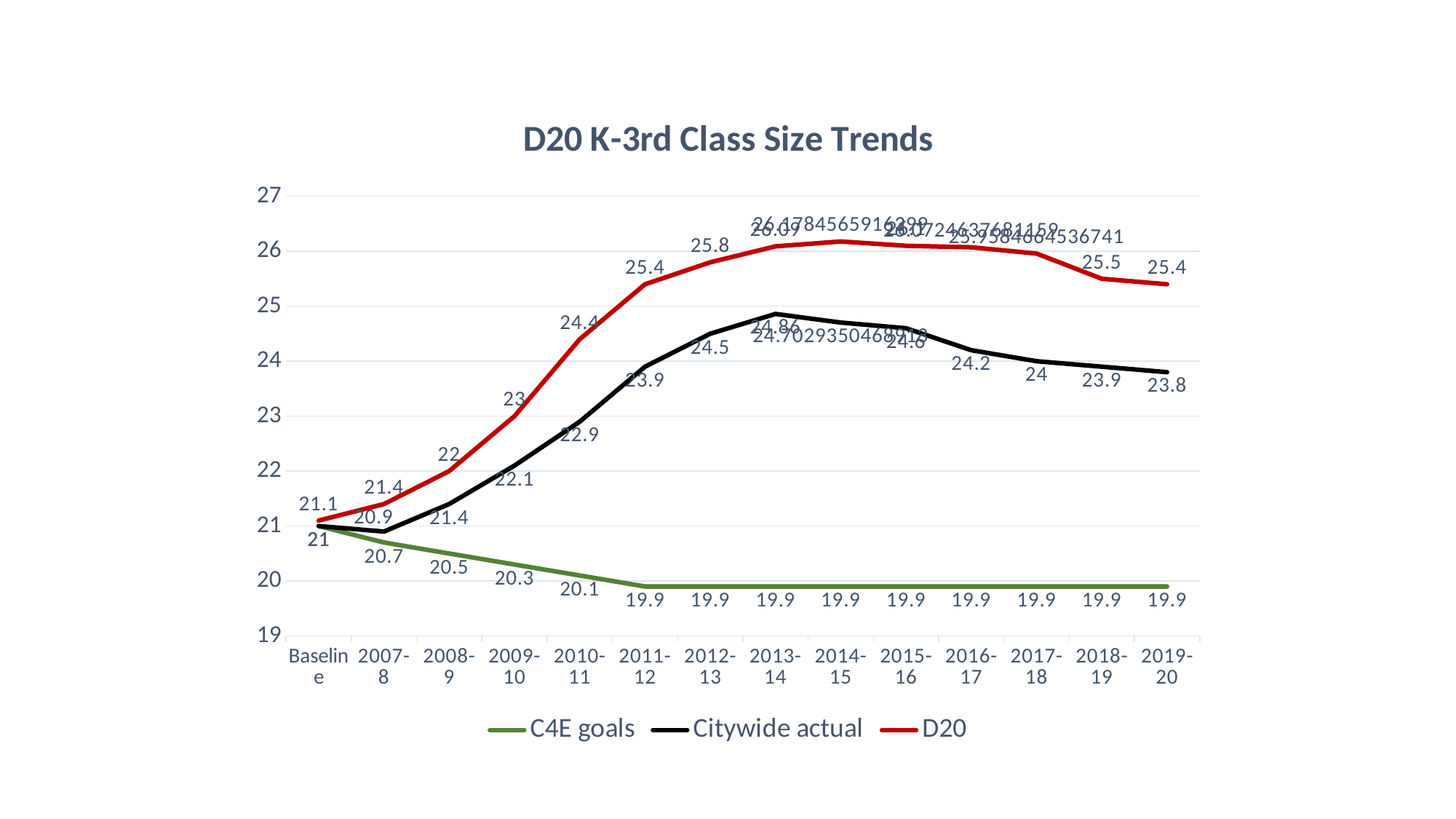
In 2012-13, which is larger: the D20 value or the Citywide actual value? D20 What is the D20 value for 2012-13? 25.8 What is the title of the chart? D20 K-3rd Class Size Trends Is the D20 value for 2014-15 greater or less than 26? greater Do the C4E goals values rise or fall from Baseline to 2011-12? fall What is the D20 value for 2019-20? 25.4 How many categories are shown along the x axis? 14 What is the C4E goals value for 2010-11? 20.1 What is the difference between the D20 and Citywide actual values in 2019-20? 1.6 What kind of chart is shown on the slide? line chart What is the Citywide actual value for 2019-20? 23.8 How many series does the legend list? 3